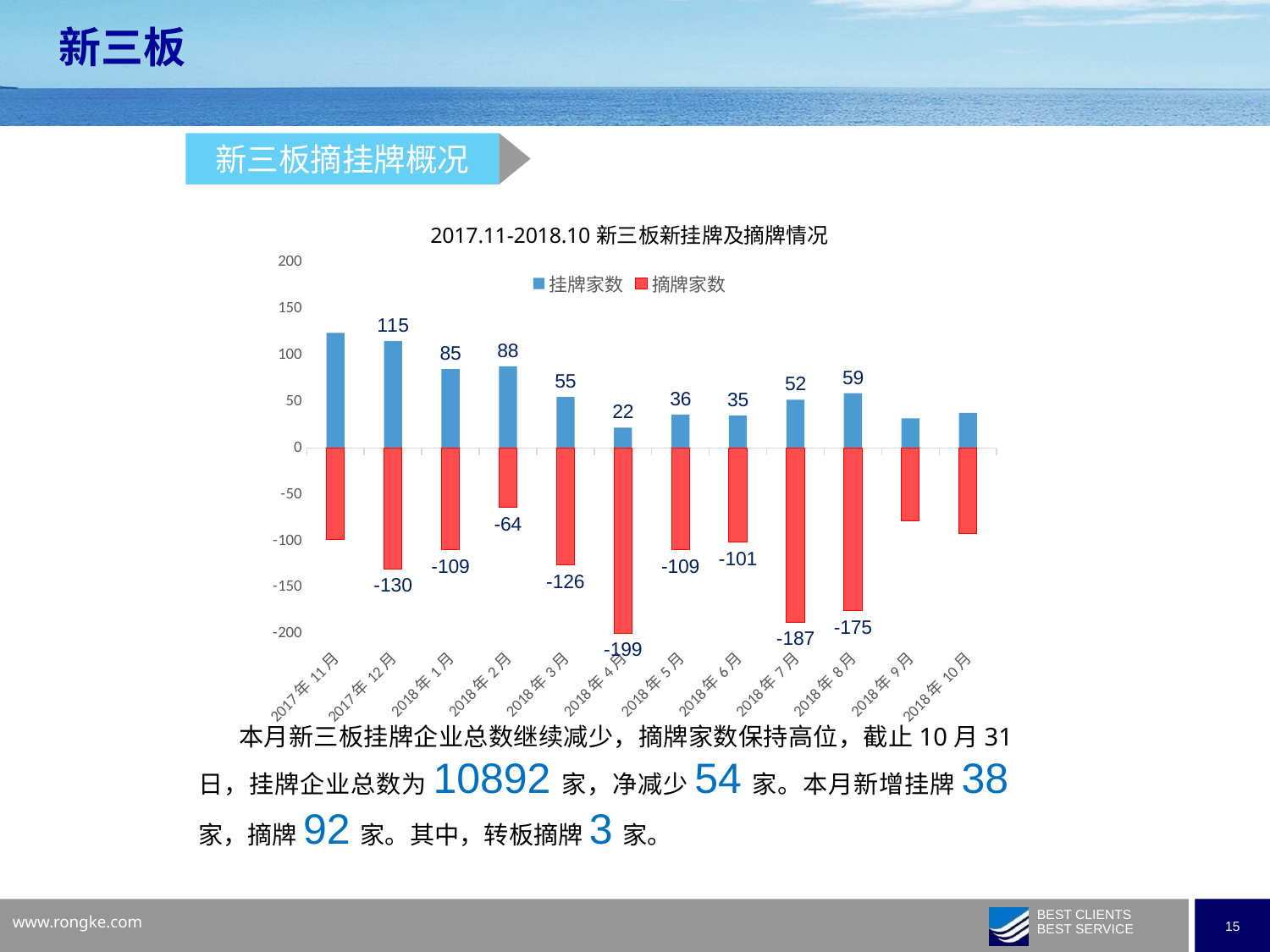
Does the 挂牌家数 series rise or fall from 2017年11月 to 2018年4月? fall Which month has the most negative 摘牌家数 value? 2018年4月 What is the 挂牌家数 value for 2018年8月? 59 Is the 挂牌家数 value for 2017年11月 greater or less than 100? greater What is the 挂牌家数 value for 2017年12月? 115 How many months are shown on the x axis of the chart? 12 What is the difference between the 挂牌家数 values for 2017年12月 and 2018年1月? 30 What is the 摘牌家数 value for 2018年4月? -199 How many series does the legend list? 2 What type of chart is shown on the slide? bar chart Which month has the lowest 挂牌家数? 2018年4月 Which is larger, the 挂牌家数 for 2018年3月 or for 2018年7月? 2018年3月